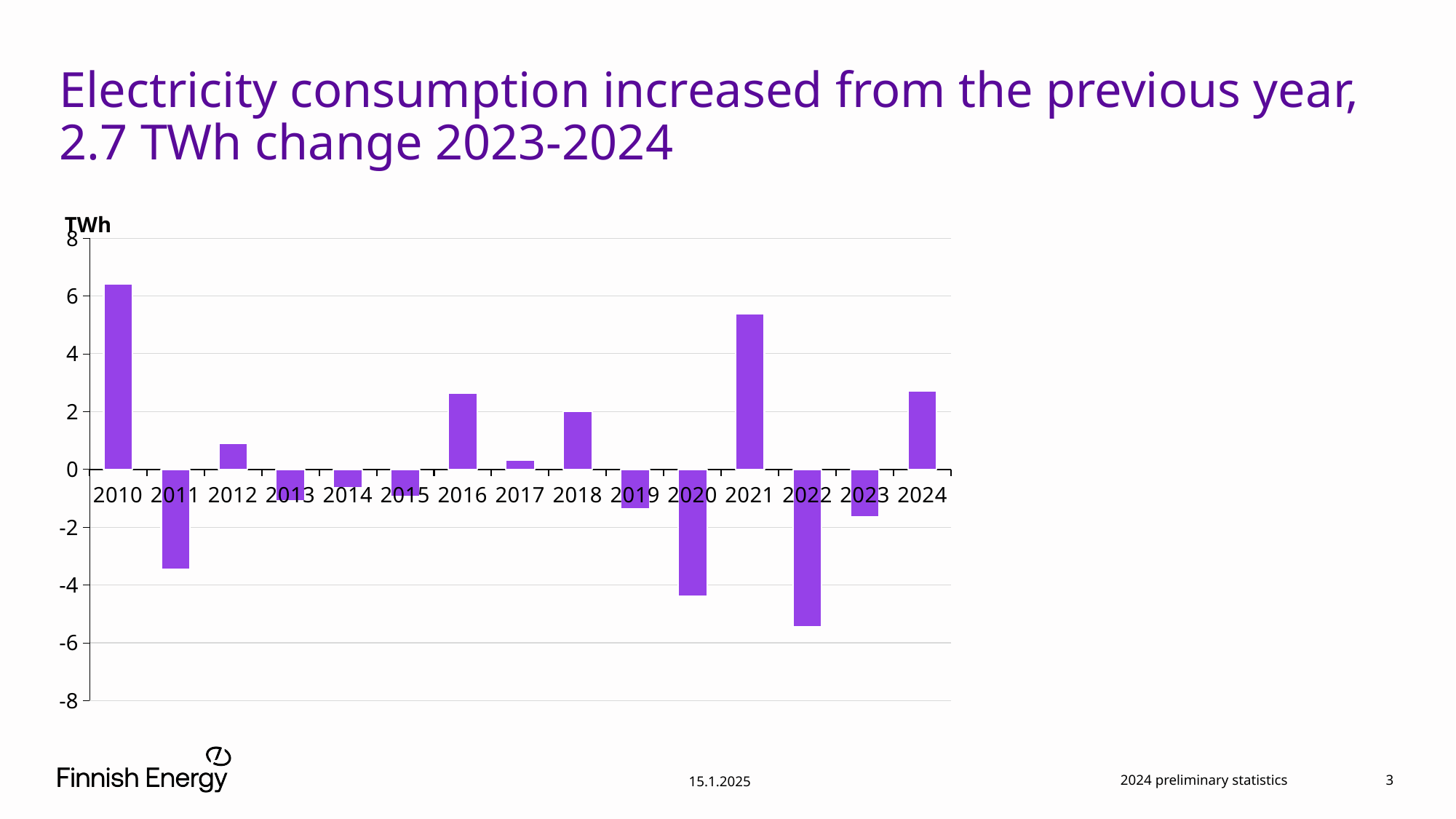
Which year has the larger value, 2021 or 2018? 2021 Which year has the highest value in the chart? 2010 What kind of chart is shown on the slide? bar chart What is the change in electricity consumption for 2024 according to the slide? 2.7 TWh What unit is shown on the y axis of the chart? TWh Is the value for 2011 greater or less than -4? greater Which year has the larger value, 2016 or 2017? 2016 How many years are plotted on the x axis of the chart? 15 Is the value for 2020 greater or less than -4? less Is the value for 2010 greater or less than 6? greater Which year has the lowest value in the chart? 2022